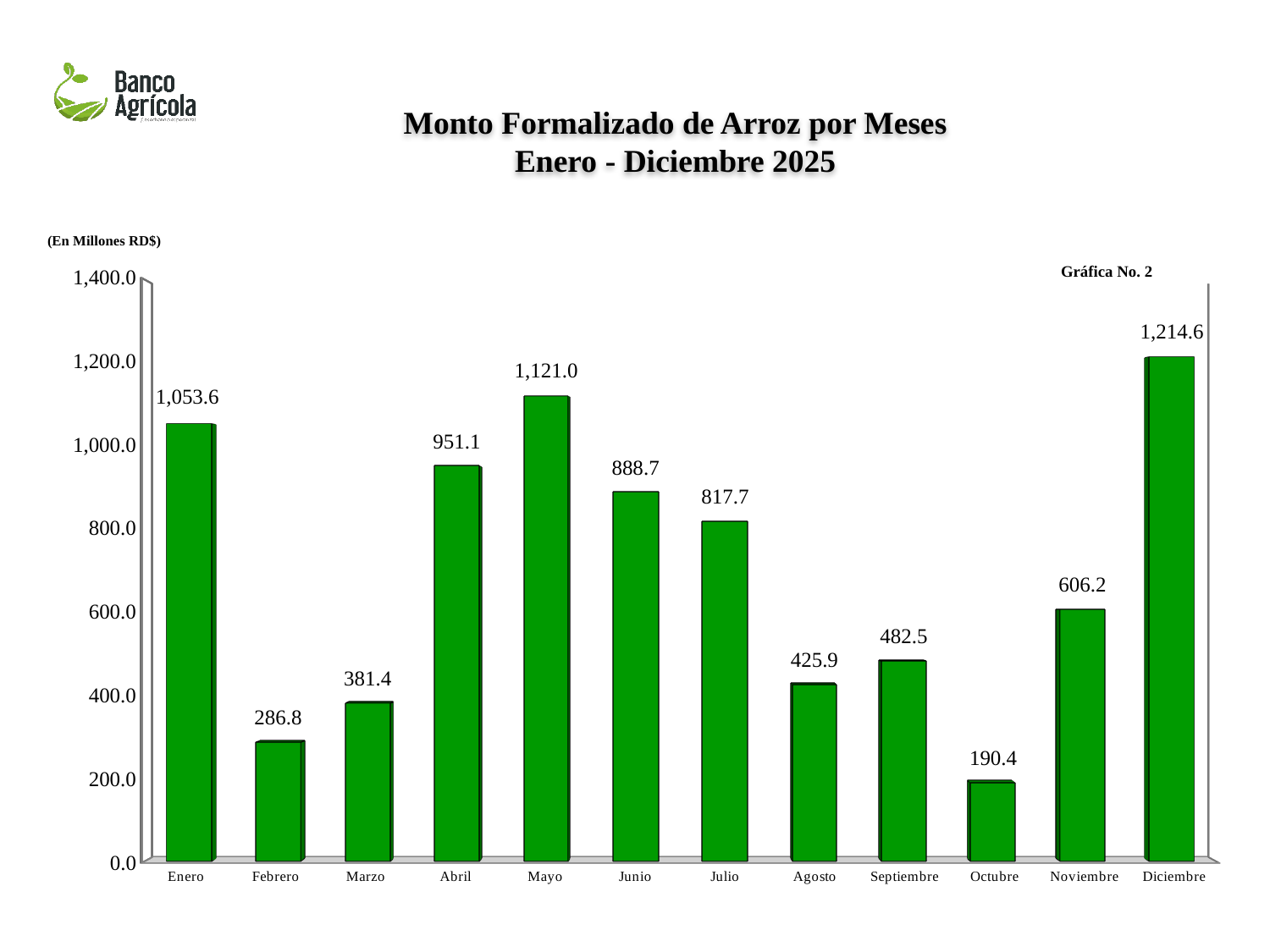
What kind of chart is shown on the slide? bar chart What is the title of the chart? Monto Formalizado de Arroz por Meses Enero - Diciembre 2025 What is the value for Noviembre? 606.2 What is the difference between the values for Marzo and Febrero? 94.6 Which is larger, the value for Junio or the value for Julio? Junio What is the value for Mayo? 1,121.0 Which month has the lowest value? Octubre What is the value for Octubre? 190.4 How many months are shown on the x axis? 12 Is the value for Abril greater or less than 1,000.0? less Which month has the highest value? Diciembre What is the difference between the values for Diciembre and Mayo? 93.6